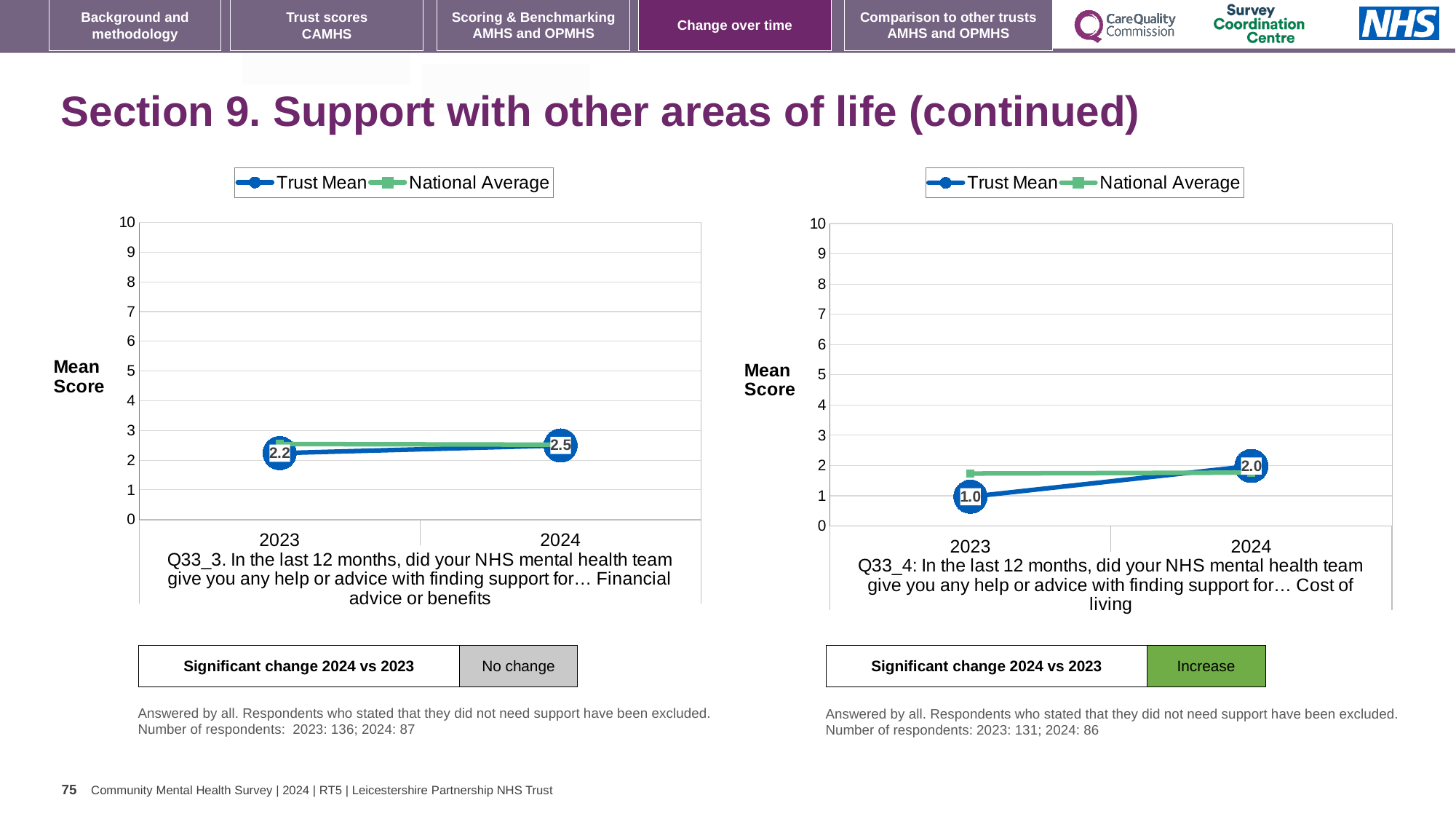
What type of chart is used on the left of the slide (Q33_3)? line chart In the left chart (Q33_3, Financial advice or benefits), what is the Trust Mean for 2024? 2.5 In the left chart (Q33_3, Financial advice or benefits), what is the difference between the Trust Mean in 2024 and in 2023? 0.3 How many series does the legend of the right chart (Q33_4, Cost of living) list? 2 In the right chart (Q33_4, Cost of living), which is higher in 2023: the Trust Mean or the National Average? National Average In the left chart (Q33_3, Financial advice or benefits), what is the Trust Mean for 2023? 2.2 In the right chart (Q33_4, Cost of living), is the National Average for 2023 greater or less than 2? less In the right chart (Q33_4, Cost of living), does the Trust Mean rise or fall from 2023 to 2024? rise In the right chart (Q33_4, Cost of living), what is the Trust Mean for 2023? 1.0 In the right chart (Q33_4, Cost of living), what is the Trust Mean for 2024? 2.0 How many years are shown on the x axis of the left chart (Q33_3, Financial advice or benefits)? 2 In the right chart (Q33_4, Cost of living), by how much did the Trust Mean change from 2023 to 2024? 1.0